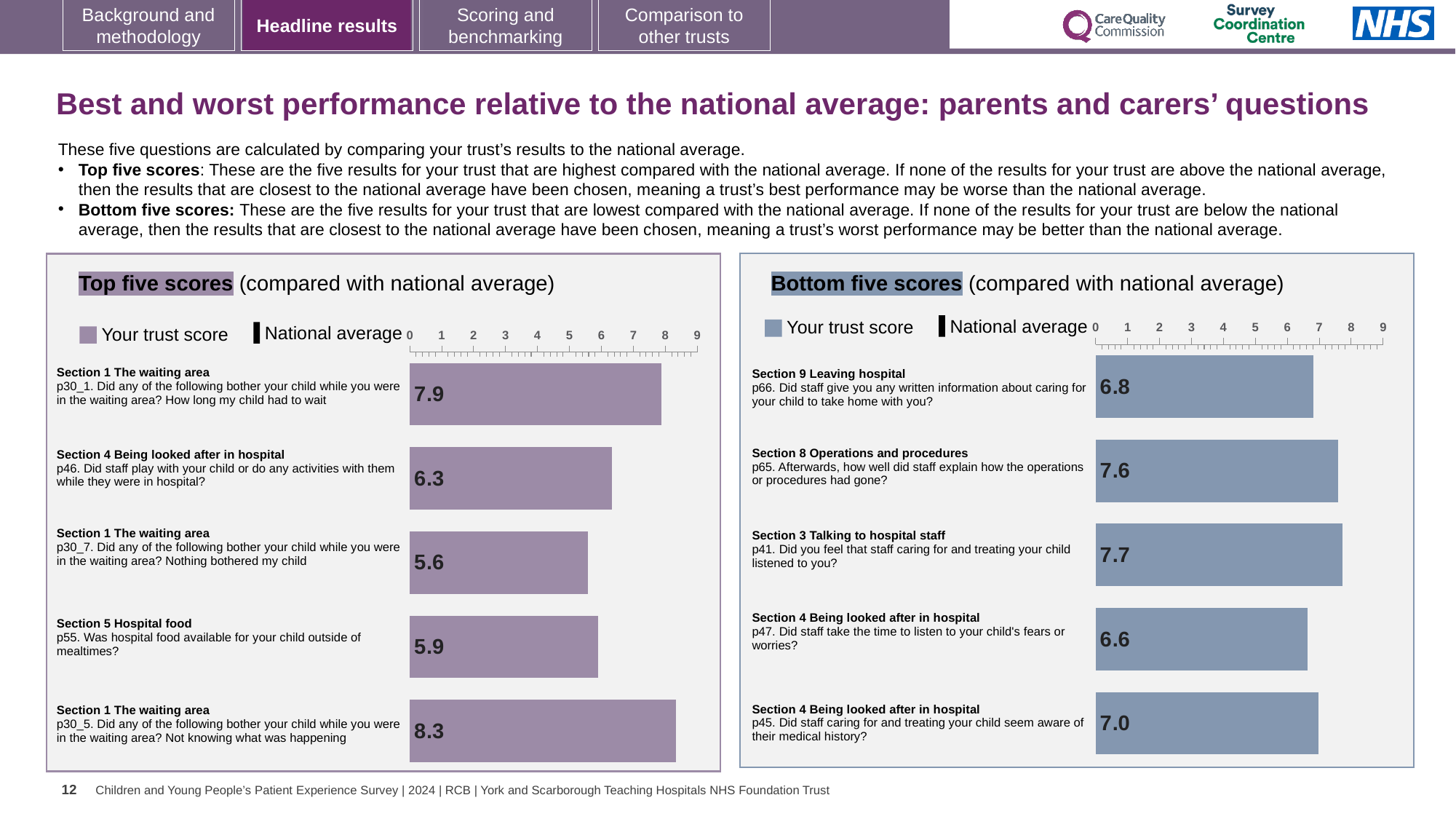
How many questions are shown in the Top five scores chart? 5 In the Bottom five scores chart, which has the larger trust score: p66 or p65? p65 In the Bottom five scores chart, which question has the lowest trust score? p47. Did staff take the time to listen to your child's fears or worries? In the Top five scores chart, what is the trust score for p55 (Was hospital food available for your child outside of mealtimes)? 5.9 In the Top five scores chart, what is the difference between the trust scores for p30_5 and p30_7? 2.7 What type of chart is the Bottom five scores chart? Bar chart In the Top five scores chart, which question has the lowest trust score? p30_7. Nothing bothered my child In the Top five scores chart, what is the trust score for p30_1 (How long my child had to wait)? 7.9 In the Top five scores chart, which question has the highest trust score? p30_5. Not knowing what was happening In the Bottom five scores chart, what is the difference between the trust scores for p65 and p47? 1.0 In the Bottom five scores chart, what is the trust score for p45 (staff seem aware of their medical history)? 7.0 In the Bottom five scores chart, what is the trust score for p66 (written information about caring for your child to take home)? 6.8